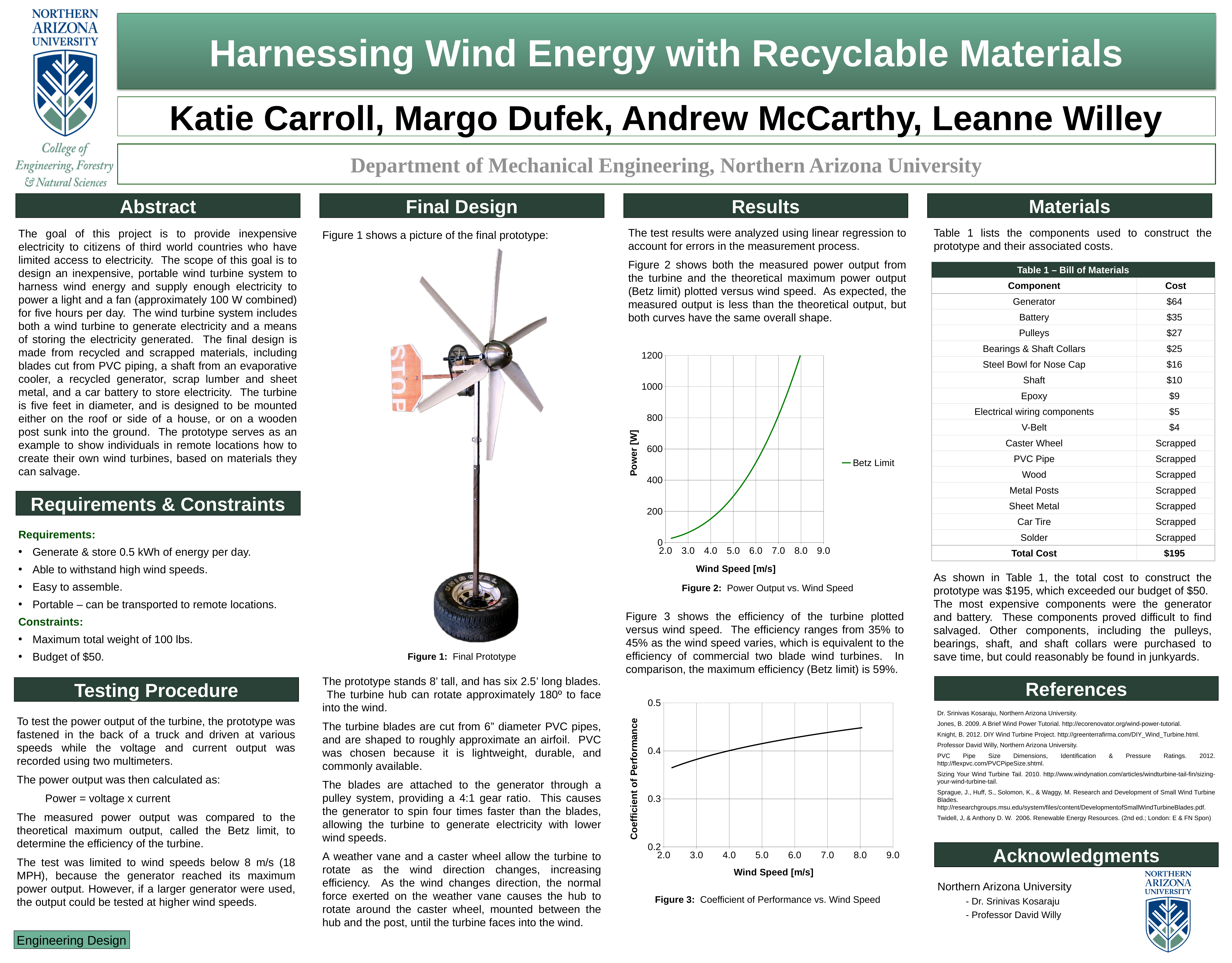
In Figure 2: Power Output vs. Wind Speed, how many series does the legend list? 1 In Figure 3: Coefficient of Performance vs. Wind Speed, is the coefficient of performance at a wind speed of 3.0 m/s greater or less than 0.4? less What is the label on the vertical axis of Figure 2: Power Output vs. Wind Speed? Power [W] In Figure 2: Power Output vs. Wind Speed, is the Betz Limit power at a wind speed of 6.0 m/s greater or less than 400? greater In Figure 2: Power Output vs. Wind Speed, does the power rise or fall as wind speed increases? rise In Figure 2: Power Output vs. Wind Speed, is the Betz Limit power at a wind speed of 5.0 m/s greater or less than 400? less In Figure 3: Coefficient of Performance vs. Wind Speed, does the coefficient of performance rise or fall as wind speed increases? rise In Figure 2: Power Output vs. Wind Speed, what is the name of the series shown in the legend? Betz Limit What kind of chart is Figure 3: Coefficient of Performance vs. Wind Speed? line chart What kind of chart is Figure 2: Power Output vs. Wind Speed? line chart